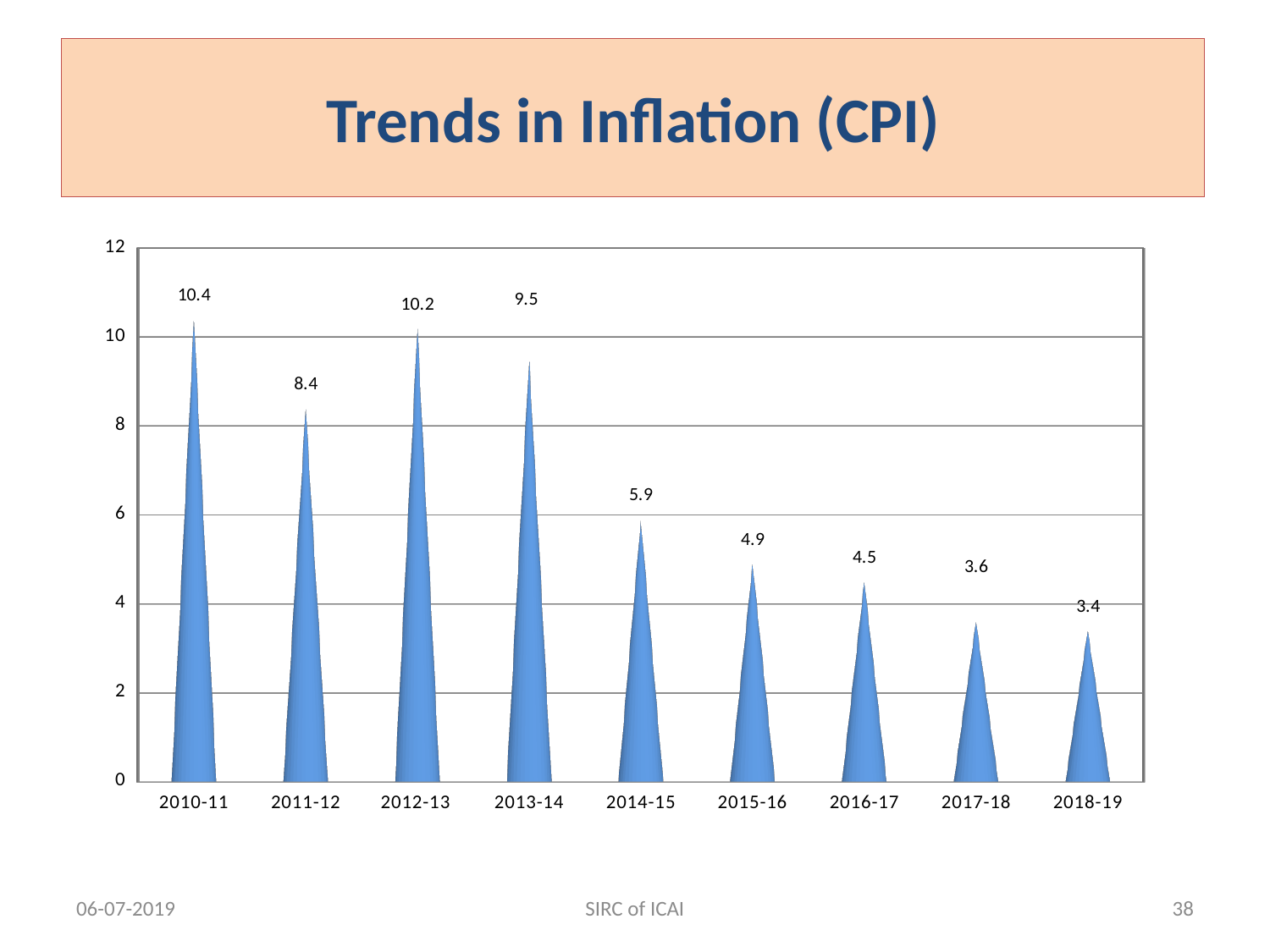
Which year has the highest CPI inflation value? 2010-11 How many years are shown on the x axis of the chart? 9 What is the CPI inflation value for 2014-15? 5.9 What kind of chart is shown on the slide? bar chart What is the CPI inflation value for 2010-11? 10.4 Do the CPI inflation values generally rise or fall from 2010-11 to 2018-19? fall Which year has the lowest CPI inflation value? 2018-19 Is the value for 2015-16 greater or less than 6? less What is the title of the slide containing the chart? Trends in Inflation (CPI) What is the difference between the CPI inflation values for 2013-14 and 2014-15? 3.6 What is the CPI inflation value for 2018-19? 3.4 Which year has a larger CPI inflation value, 2011-12 or 2012-13? 2012-13